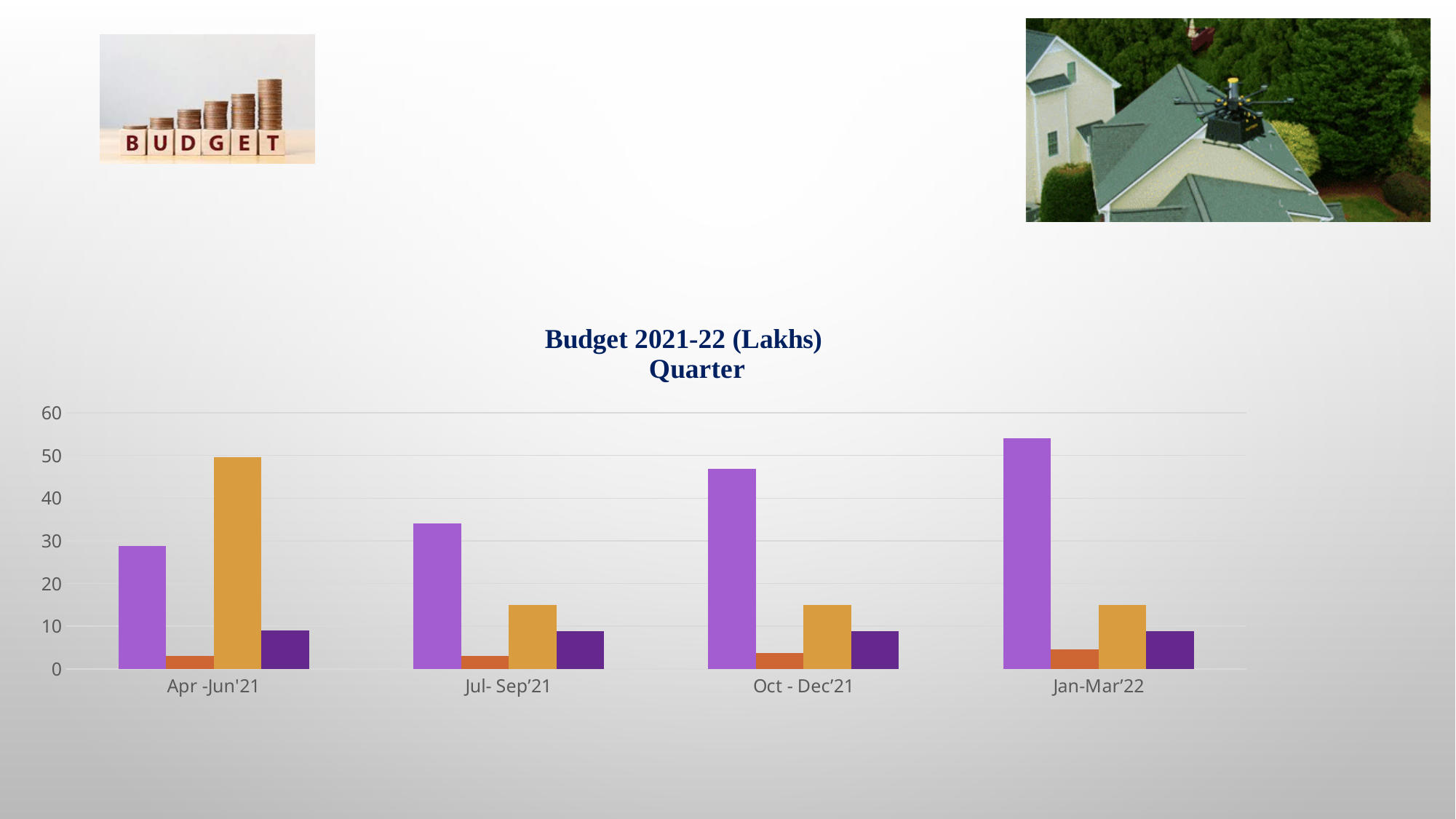
In which quarter is the light purple bar the tallest? Jan-Mar'22 In Apr -Jun'21, which is taller: the gold bar or the light purple bar? the gold bar Is the light purple bar for Jan-Mar'22 greater or less than 50? greater In which quarter is the gold bar the tallest? Apr -Jun'21 Is the gold bar for Jul- Sep'21 greater or less than 20? less What is the title of the chart? Budget 2021-22 (Lakhs) Quarter How many bars are plotted for each quarter? 4 What kind of chart is shown on the slide? bar chart How many quarters are shown on the x axis of the chart? 4 In which quarter is the light purple bar the shortest? Apr -Jun'21 Do the light purple bars rise or fall from Apr -Jun'21 to Jan-Mar'22? rise